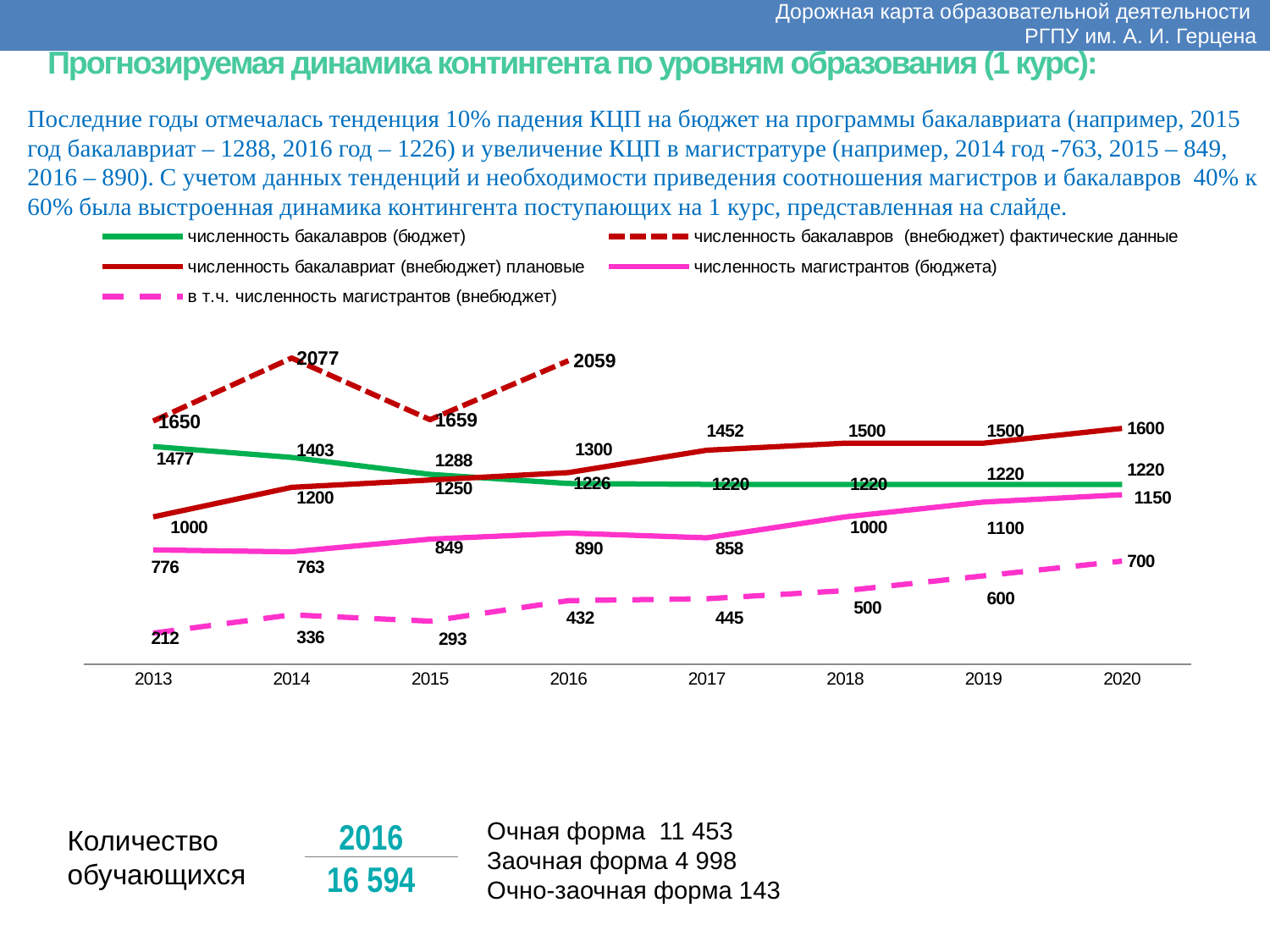
In 2020, which is larger: 'численность бакалавриат (внебюджет) плановые' or 'численность бакалавров (бюджет)'? численность бакалавриат (внебюджет) плановые How many series does the chart legend list? 5 What is the value of 'численность бакалавров (внебюджет) фактические данные' in 2014? 2077 By how much does 'численность бакалавров (бюджет)' decrease from 2013 to 2020? 257 In which year is 'в т.ч. численность магистрантов (внебюджет)' lowest? 2013 By how much does 'численность бакалавриат (внебюджет) плановые' increase from 2013 to 2020? 600 What is the value of 'численность магистрантов (бюджета)' in 2017? 858 How many years are shown on the x axis of the chart? 8 Does 'в т.ч. численность магистрантов (внебюджет)' generally rise or fall from 2013 to 2020? Rise In which year is 'численность бакалавров (внебюджет) фактические данные' highest? 2014 What type of chart is shown on the slide? Line chart What is the value of 'численность бакалавров (бюджет)' in 2015? 1288